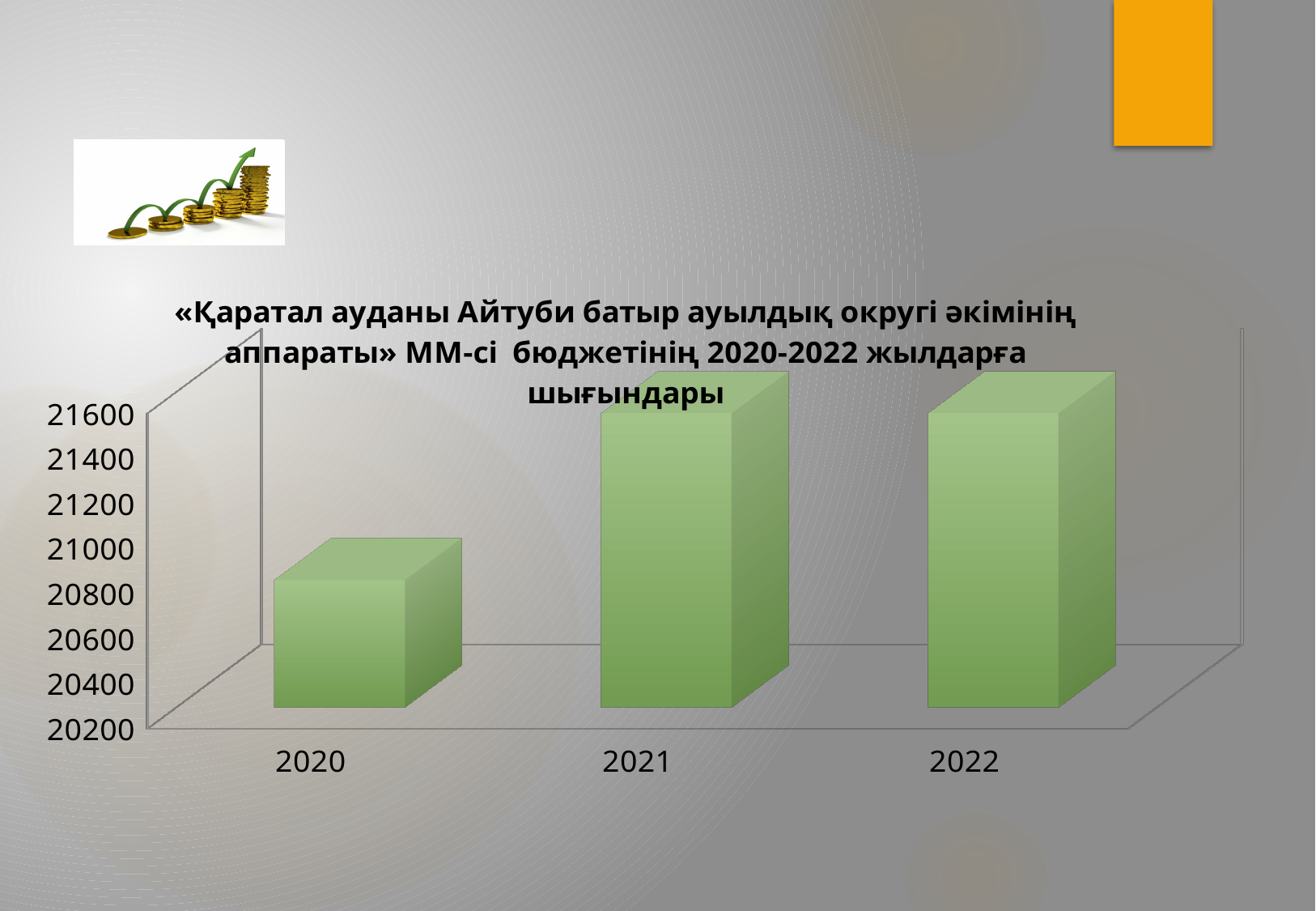
How many years (categories) are shown on the x axis of the chart? 3 Which is larger, the value for 2022 or the value for 2020? 2022 Is the value for 2022 greater or less than 21000? greater Is the value for 2020 greater or less than 21000? less What kind of chart is shown on the slide? bar chart Which year has the lowest value in the chart? 2020 Which is larger, the value for 2020 or the value for 2021? 2021 Which years does the chart title say the budget expenditures cover? 2020-2022 Does the value rise or fall from 2020 to 2021? rise Is the value for 2021 greater or less than 21200? greater What is the lowest value shown on the vertical axis of the chart? 20200